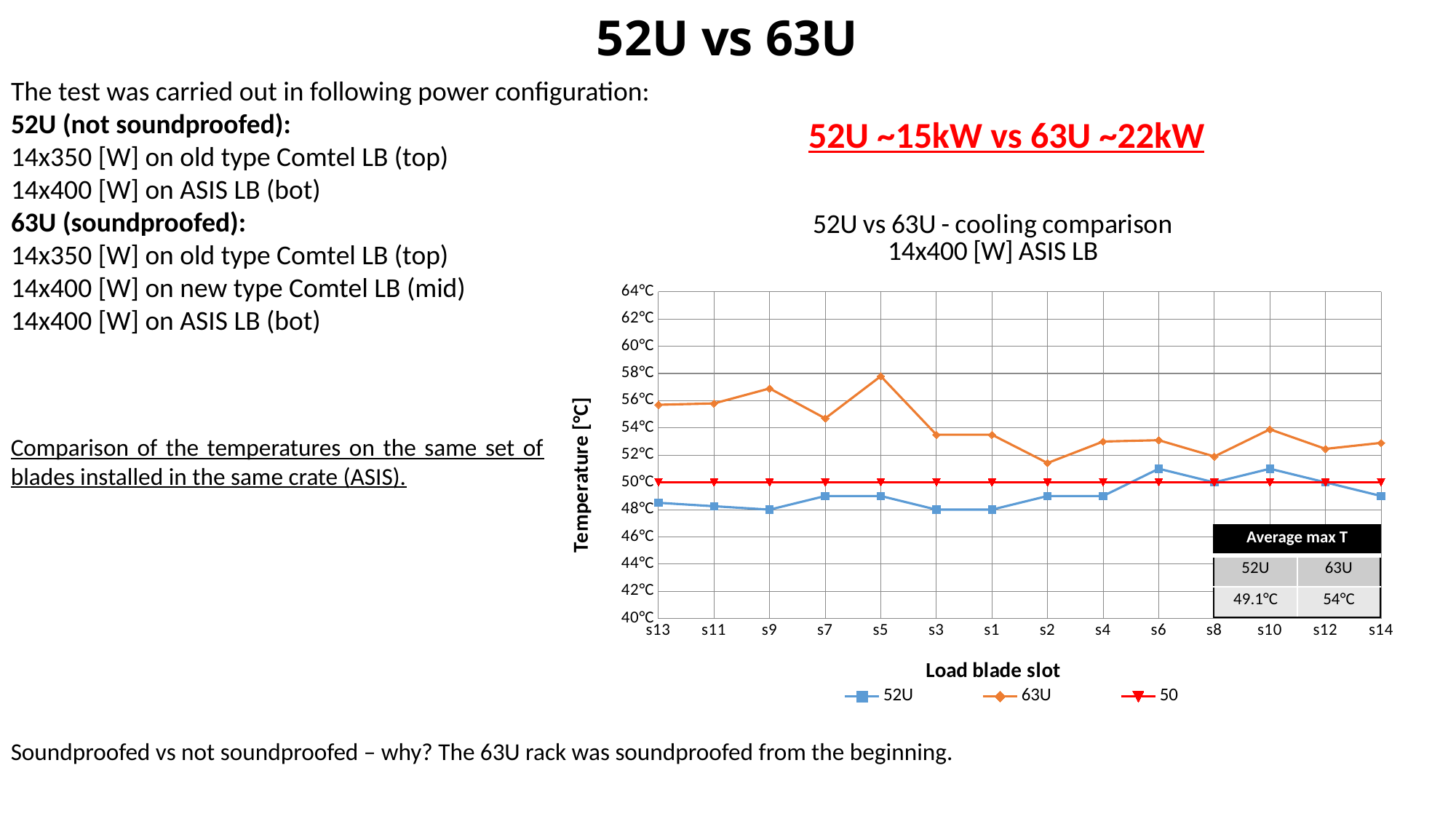
Does the 63U series generally rise or fall from s13 to s14? fall What kind of chart is shown on the slide? line chart What is the label of the chart's y axis? Temperature [°C] At which load blade slot does the 63U series reach its highest temperature? s5 Is the 52U temperature at s13 greater or less than 50°C? less Is the 63U temperature at s5 greater or less than 56°C? greater How many load blade slots are shown on the x axis of the chart? 14 Is the 63U temperature at s13 greater or less than 54°C? greater According to the Average max T table on the chart, what is the average max temperature for 52U? 49.1°C According to the Average max T table on the chart, what is the average max temperature for 63U? 54°C At s5, which series has the higher temperature, 52U or 63U? 63U How many series does the chart legend list? 3